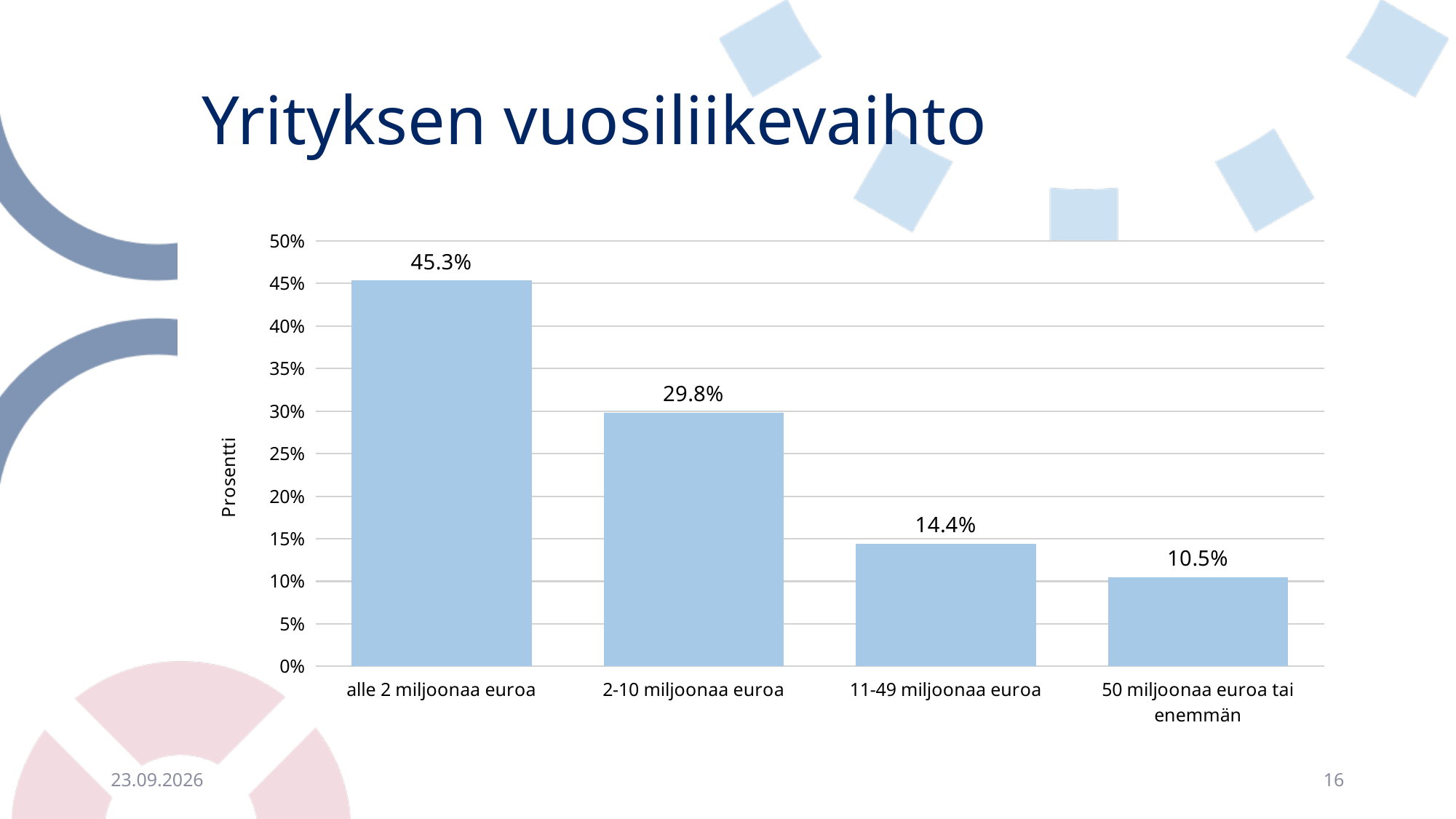
Which is larger, the value for '11-49 miljoonaa euroa' or '50 miljoonaa euroa tai enemmän'? 11-49 miljoonaa euroa What is the difference between the values for 'alle 2 miljoonaa euroa' and '2-10 miljoonaa euroa'? 15.5% Is the value for '2-10 miljoonaa euroa' greater or less than 25%? greater What is the value for '2-10 miljoonaa euroa'? 29.8% Which category has the lowest value? 50 miljoonaa euroa tai enemmän What is the label of the vertical axis? Prosentti Which category has the highest value? alle 2 miljoonaa euroa What is the value for 'alle 2 miljoonaa euroa'? 45.3% How many categories are shown on the x axis? 4 What is the value for '11-49 miljoonaa euroa'? 14.4% What kind of chart is shown on the slide? bar chart What is the value for '50 miljoonaa euroa tai enemmän'? 10.5%